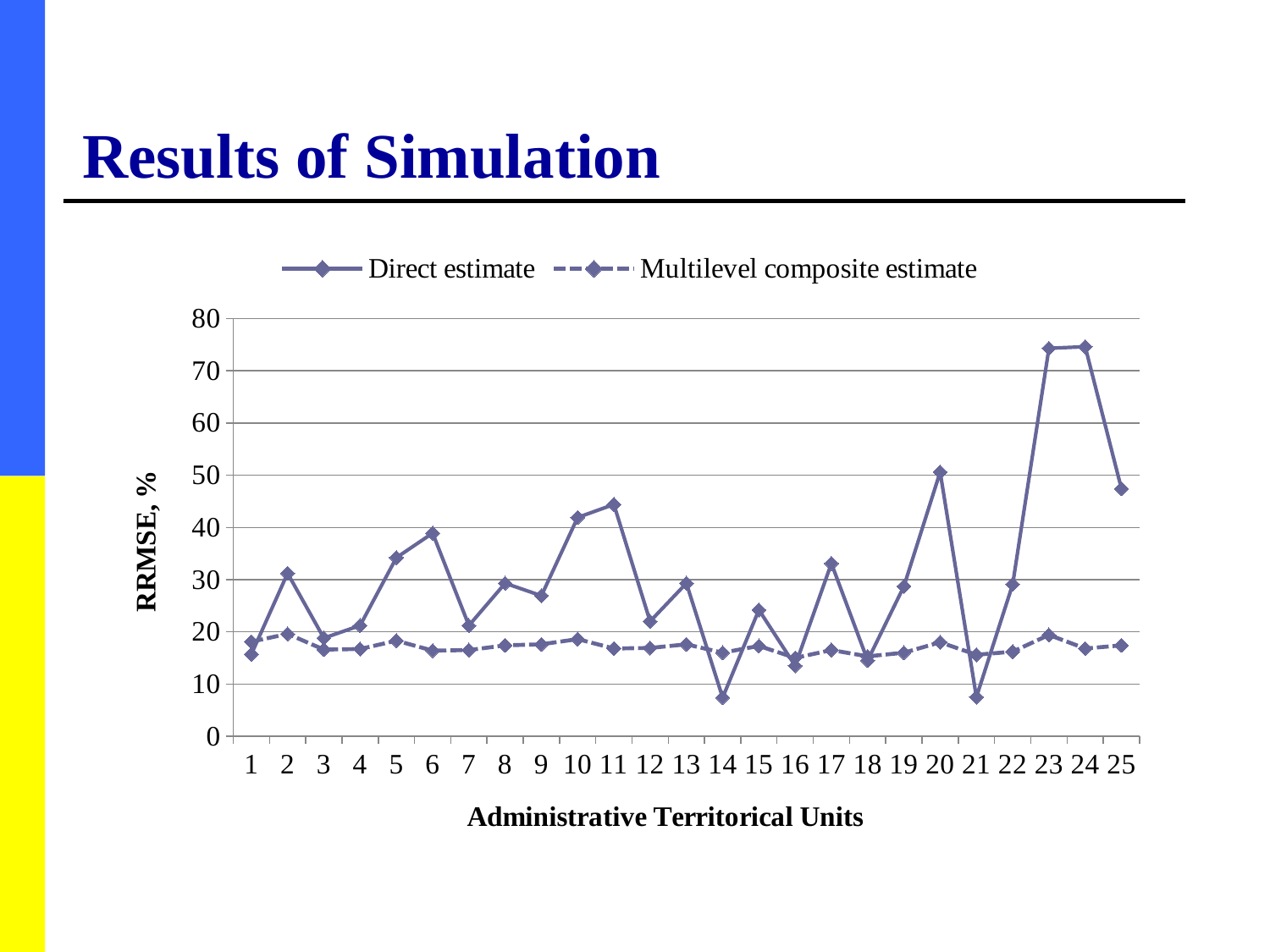
For the Direct estimate, which unit has the larger value, unit 10 or unit 12? unit 10 Is the Direct estimate value for unit 14 greater or less than 10? less How many series does the legend list? 2 At unit 14, which series has the larger value, Direct estimate or Multilevel composite estimate? Multilevel composite estimate Is the Multilevel composite estimate value for unit 10 greater or less than 20? less Is the Direct estimate value for unit 25 greater or less than 50? less Which series is drawn with a dashed line? Multilevel composite estimate What kind of chart is shown on the slide? line chart How many administrative territorial units are plotted along the x axis? 25 What is the label of the y axis? RRMSE, %